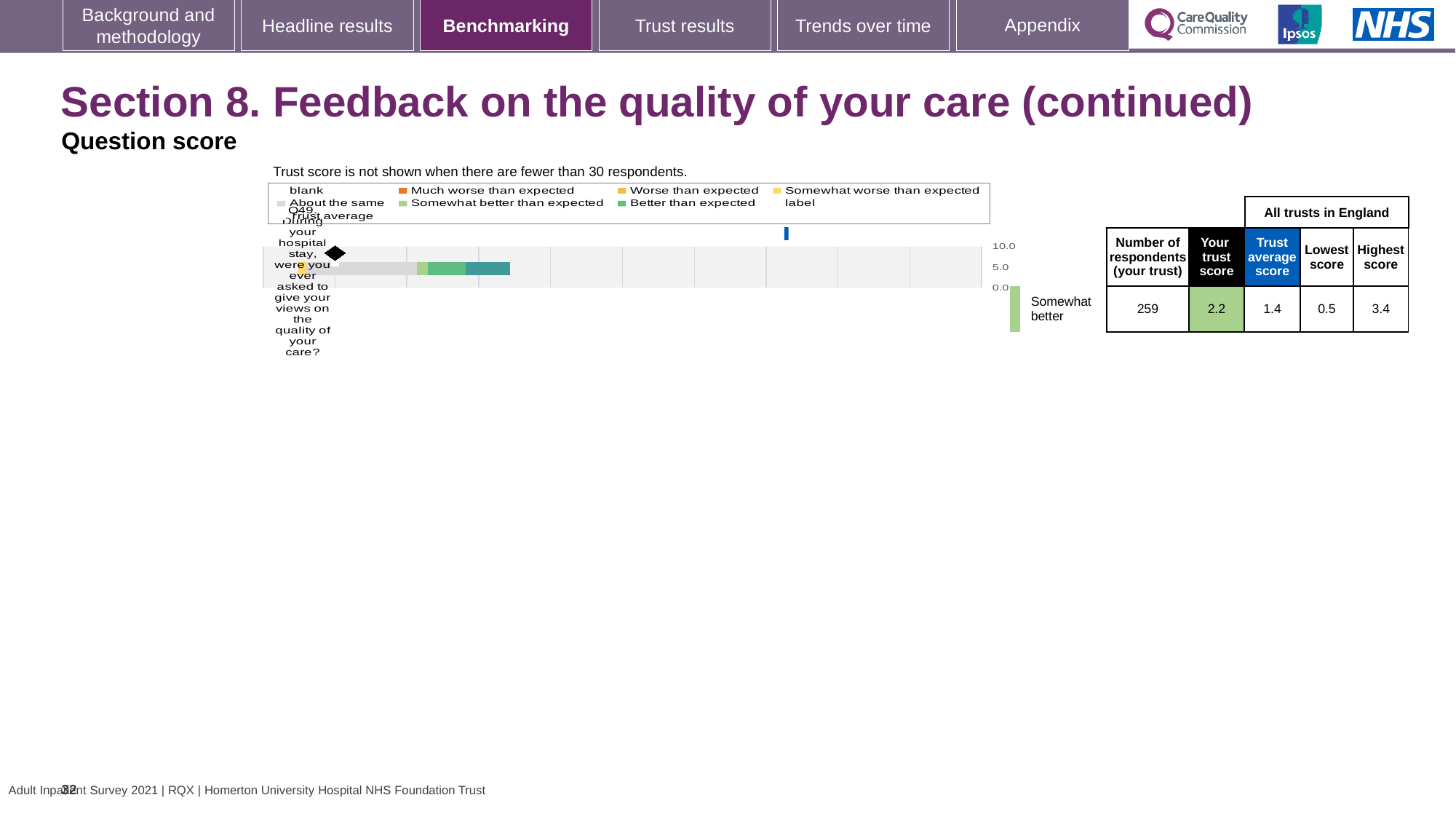
What is the difference between the highest and lowest scores among all trusts in England for Q49? 2.9 Which question number is plotted in the chart? Q49 What is the highest value shown on the chart's numeric axis? 10.0 In the table beside the chart, what is your trust score for Q49? 2.2 What is the difference between your trust score and the trust average score for Q49? 0.8 What kind of chart is used to show the Q49 benchmarking result? Bar chart In the table beside the chart, what is the lowest score among all trusts in England? 0.5 Which is larger for Q49: your trust score or the trust average score? Your trust score In the table beside the chart, what is the trust average score for all trusts in England? 1.4 In the table beside the chart, what is the number of respondents for your trust? 259 Which benchmarking category is the trust's Q49 result labelled as next to the chart? Somewhat better In the table beside the chart, what is the highest score among all trusts in England? 3.4